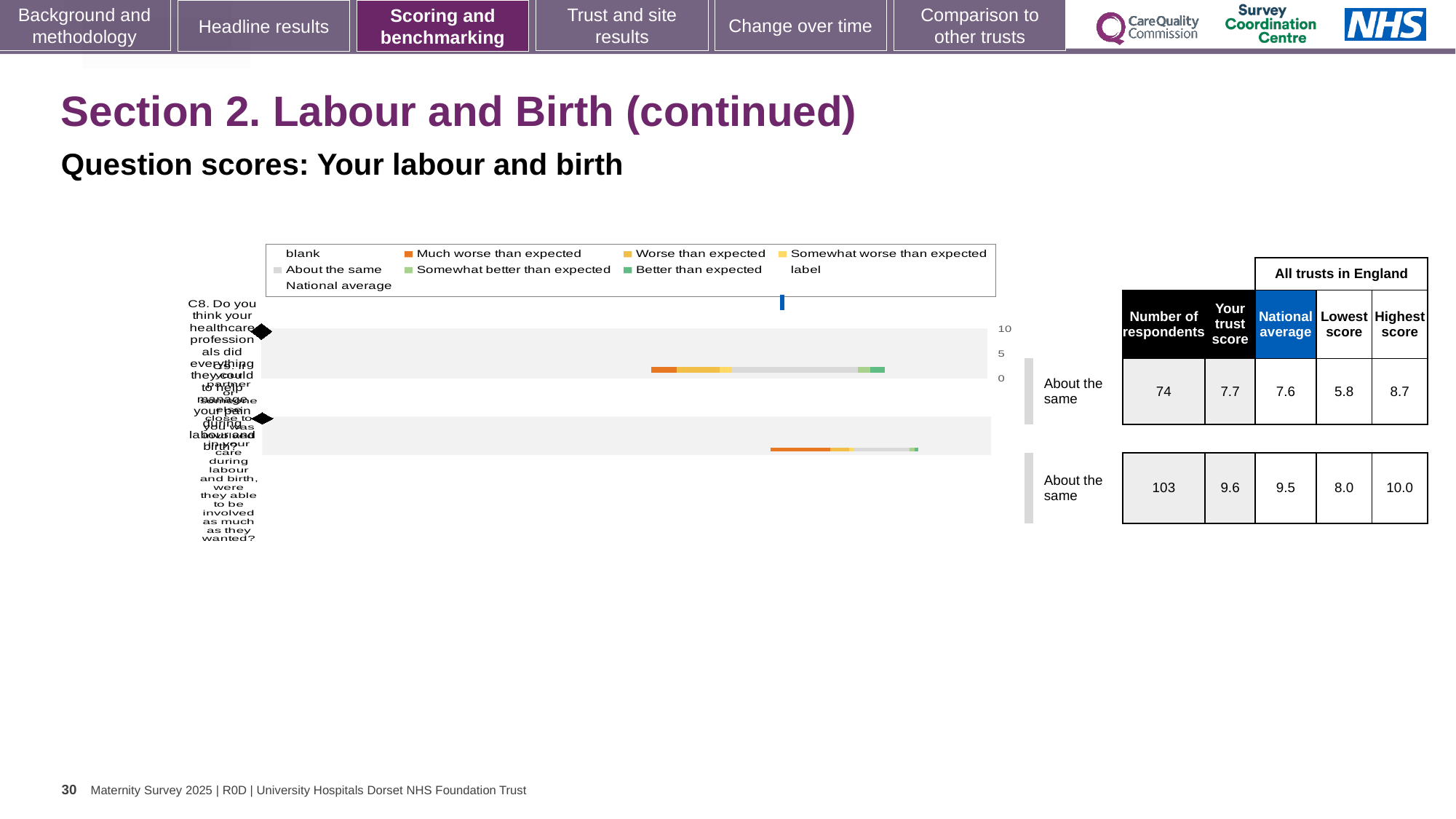
For the second row of the table, what is the difference between the highest score and the lowest score? 2.0 What kind of chart is shown on the slide? bar chart Which row of the table has the larger number of respondents? the second row (103) In the table beside the chart, what is 'Your trust score' for the first row? 7.7 For the first row of the table, which is larger: 'Your trust score' or the national average? Your trust score How many bars (question rows) are plotted in the chart? 2 In the table beside the chart, what is the national average for the second row? 9.5 In the table beside the chart, what is the highest score for the second row? 10.0 Which legend entry is shown in grey? About the same In the table beside the chart, what is the number of respondents for the first row? 74 Which colour does the legend use for 'Much worse than expected'? orange For the first row of the table, what is the difference between the highest score and the lowest score? 2.9